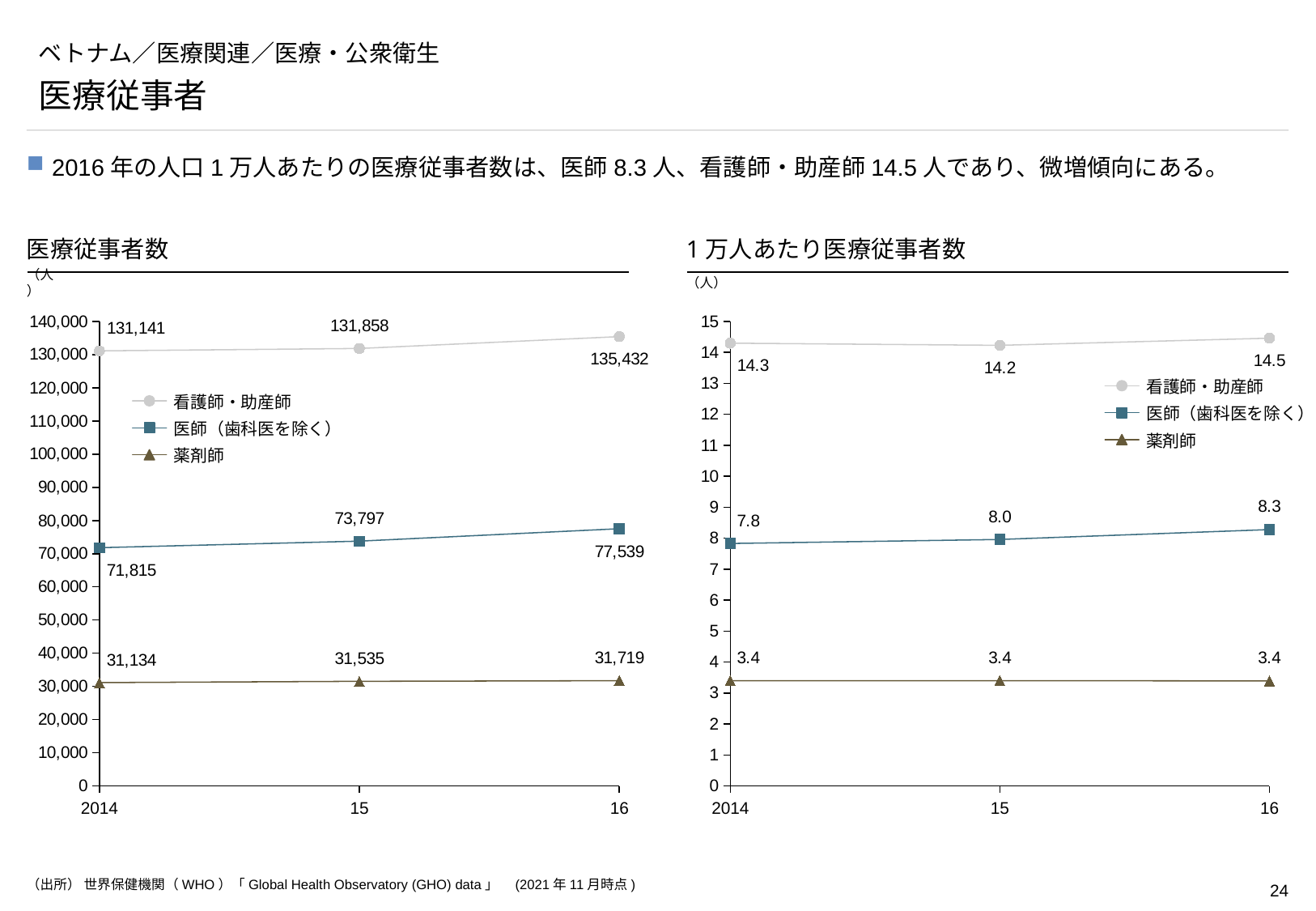
In the right chart (1万人あたり医療従事者数), what is the difference between the 看護師・助産師 value in 2016 and the 医師（歯科医を除く） value in 2016? 6.2 In the left chart (医療従事者数), does the 医師（歯科医を除く） series rise or fall from 2014 to 2016? Rise In the right chart (1万人あたり医療従事者数), what is the value for 医師（歯科医を除く） in 2016? 8.3 In the left chart (医療従事者数), what is the difference between the 医師（歯科医を除く） values for 2016 and 2015? 3,742 How many series does the legend of the left chart (医療従事者数) list? 3 In the left chart (医療従事者数), what is the value for 医師（歯科医を除く） in 2014? 71,815 What kind of chart is the right chart (1万人あたり医療従事者数)? Line chart In the right chart (1万人あたり医療従事者数), which series has the lowest values? 薬剤師 In the left chart (医療従事者数), what is the value for 薬剤師 in 2015? 31,535 In the right chart (1万人あたり医療従事者数), what is the value for 看護師・助産師 in 2015? 14.2 In the left chart (医療従事者数), which series has the highest values? 看護師・助産師 In the left chart (医療従事者数), what is the value for 看護師・助産師 in 2016? 135,432